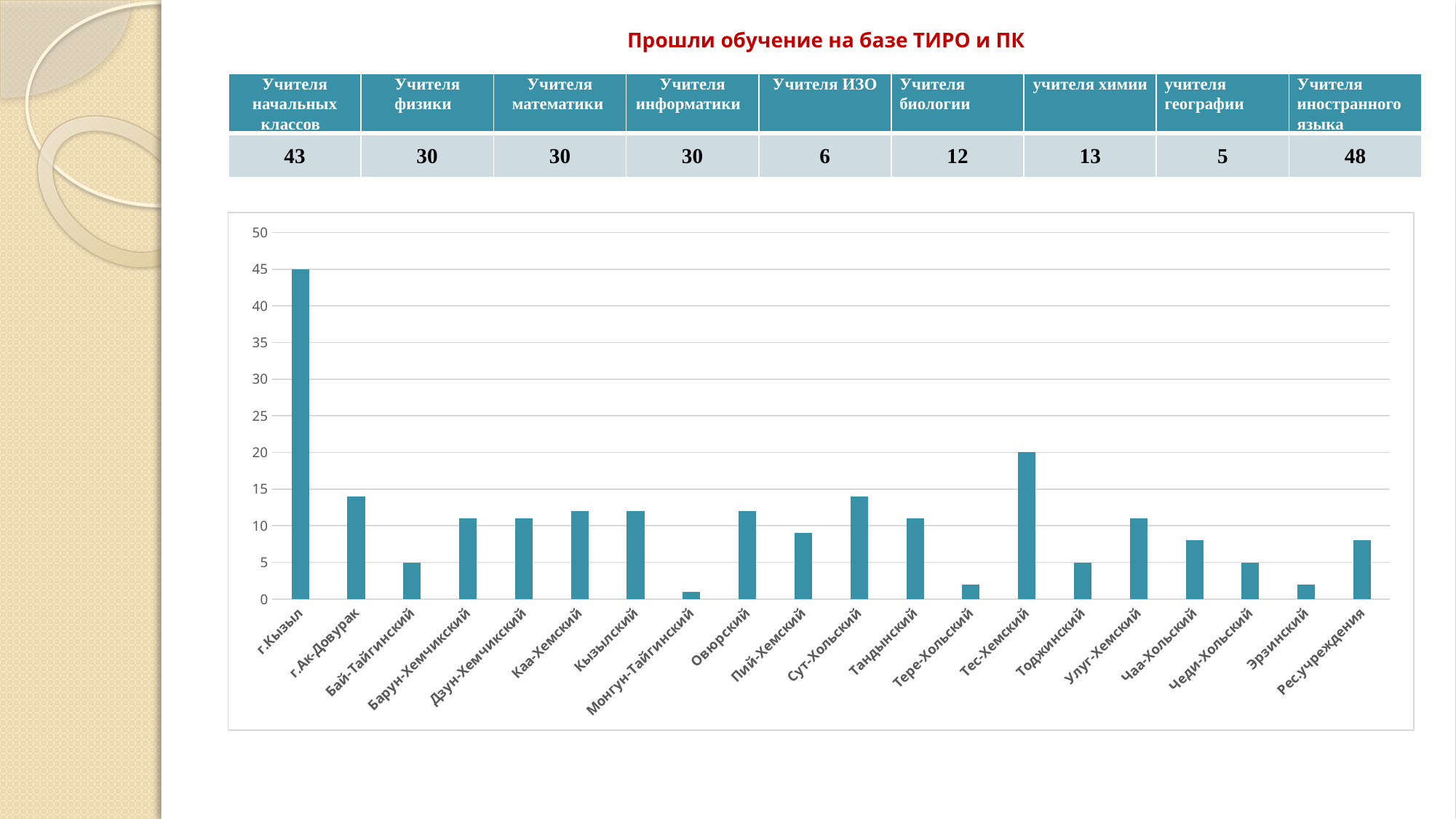
Which is larger, the value for г.Ак-Довурак or the value for Бай-Тайгинский? г.Ак-Довурак Is the value for г.Ак-Довурак greater or less than 10? greater What is the highest value shown on the y axis of the chart? 50 Which category has the highest bar in the chart? г.Кызыл What is the value for г.Кызыл in the chart? 45 What kind of chart is shown on the slide? bar chart Which is larger, the value for Тес-Хемский or the value for Сут-Хольский? Тес-Хемский Is the value for Монгун-Тайгинский greater or less than 5? less What is the value for Бай-Тайгинский in the chart? 5 What is the value for Тес-Хемский in the chart? 20 What is the difference between the values for г.Кызыл and Тес-Хемский? 25 How many categories are plotted on the x axis of the bar chart? 20